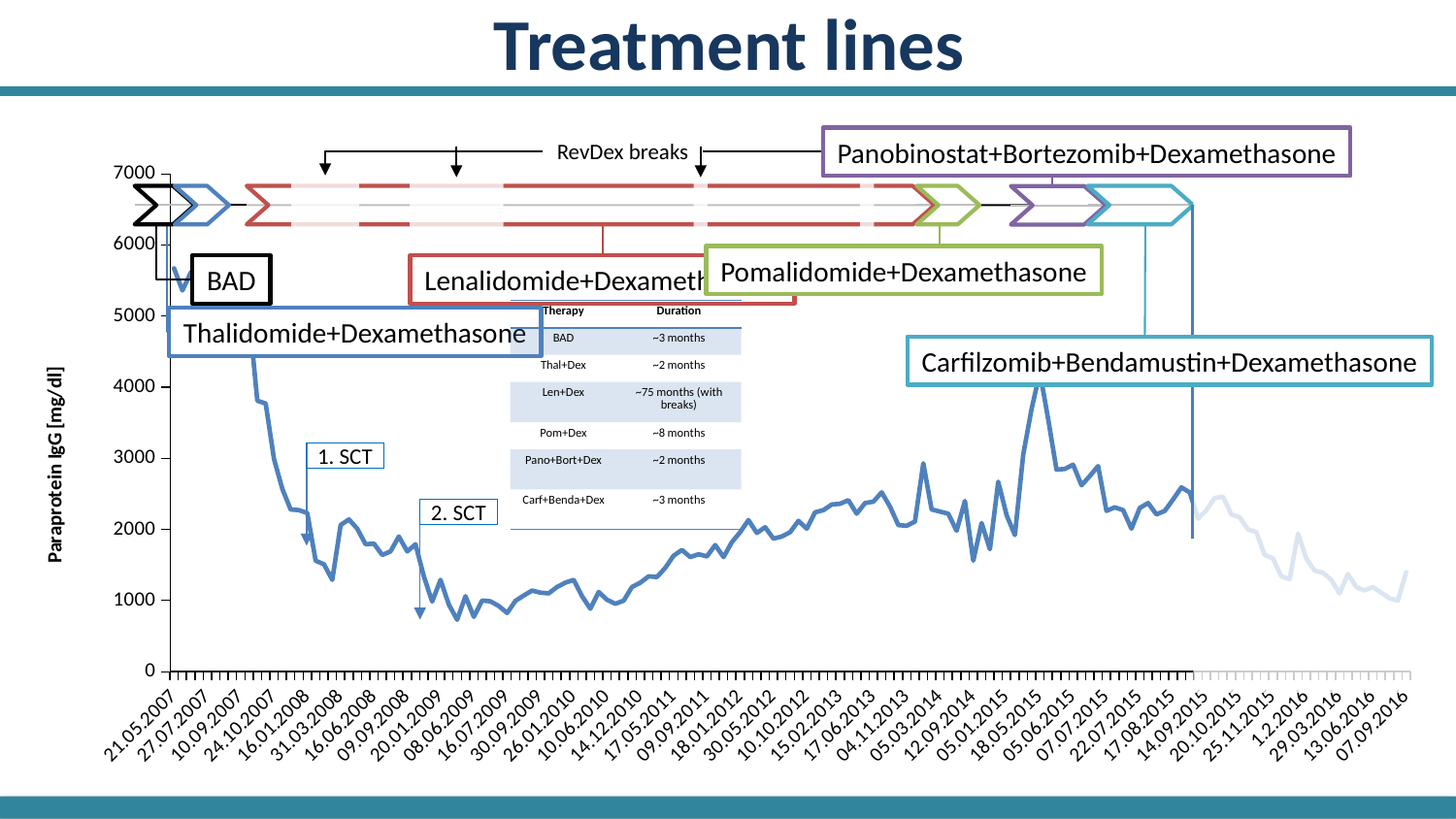
Is the paraprotein IgG value at 17.06.2013 greater or less than 2000? greater Is the paraprotein IgG value at 17.05.2011 greater or less than 2000? less Is the paraprotein IgG value at 16.01.2008 greater or less than 3000? less Do the paraprotein IgG values rise or fall between 21.05.2007 and 31.03.2008? fall What kind of chart is shown on the slide? line chart Do the paraprotein IgG values rise or fall between 20.01.2009 and 17.06.2013? rise What is the highest tick value shown on the vertical axis? 7000 Is the paraprotein IgG value at 18.05.2015 larger or smaller than the value at 31.03.2008? larger What is the label of the vertical axis of the chart? Paraprotein IgG [mg/dl]